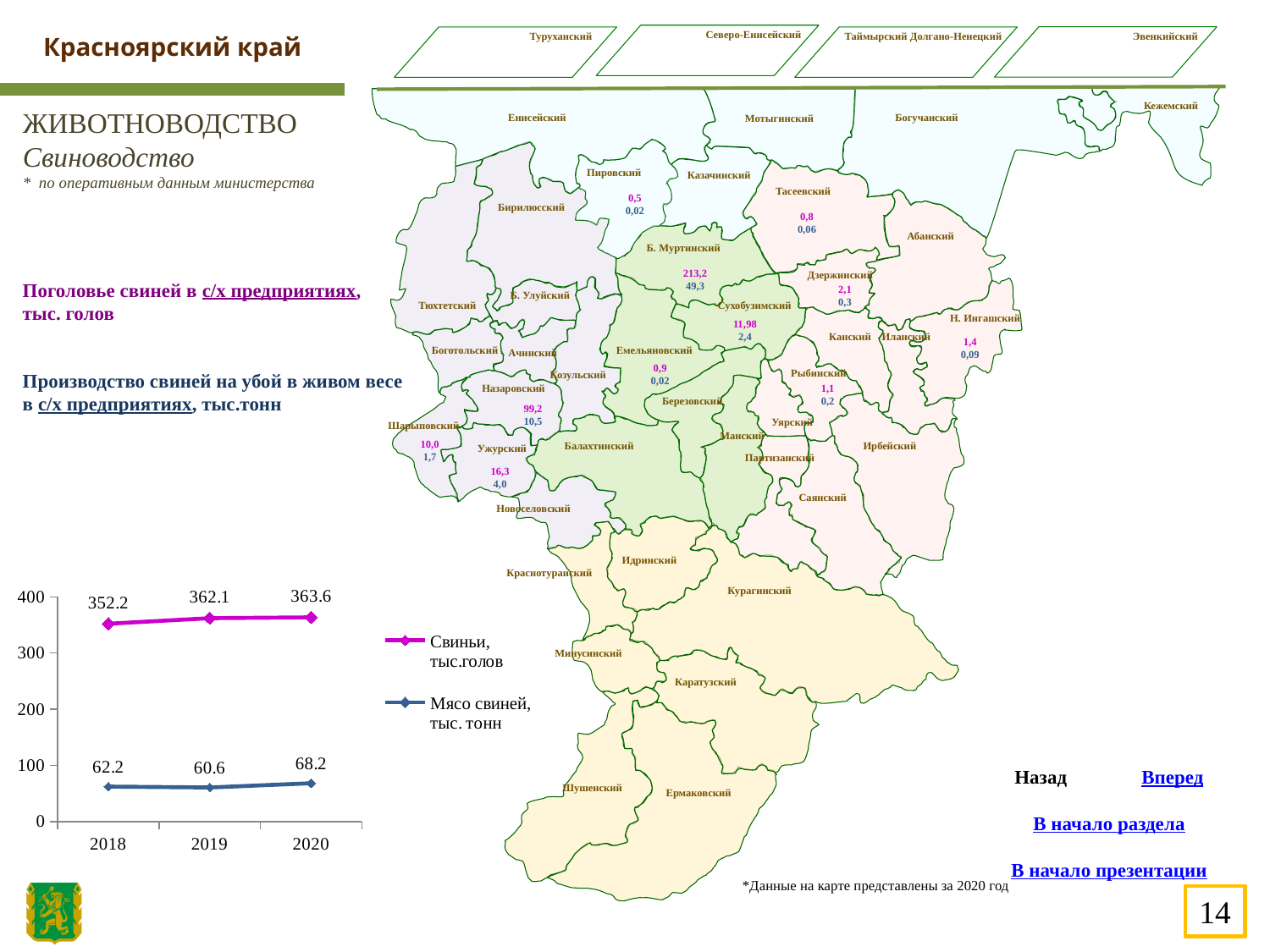
What is the difference between the Мясо свиней, тыс. тонн values for 2020 and 2019? 7.6 In which year is Свиньи, тыс.голов lowest? 2018 How many series does the legend of the line chart list? 2 What is the value for Свиньи, тыс.голов in 2018? 352.2 In which year is Мясо свиней, тыс. тонн highest? 2020 Is the value for Свиньи, тыс.голов in 2019 greater or less than 300? greater What is the difference between the Свиньи, тыс.голов values for 2019 and 2018? 9.9 What kind of chart is shown in the bottom-left of the slide? line chart What is the value for Мясо свиней, тыс. тонн in 2019? 60.6 Which is larger for Мясо свиней, тыс. тонн: 2018 or 2020? 2020 How many years are shown on the x axis of the line chart? 3 What is the value for Свиньи, тыс.голов in 2020? 363.6